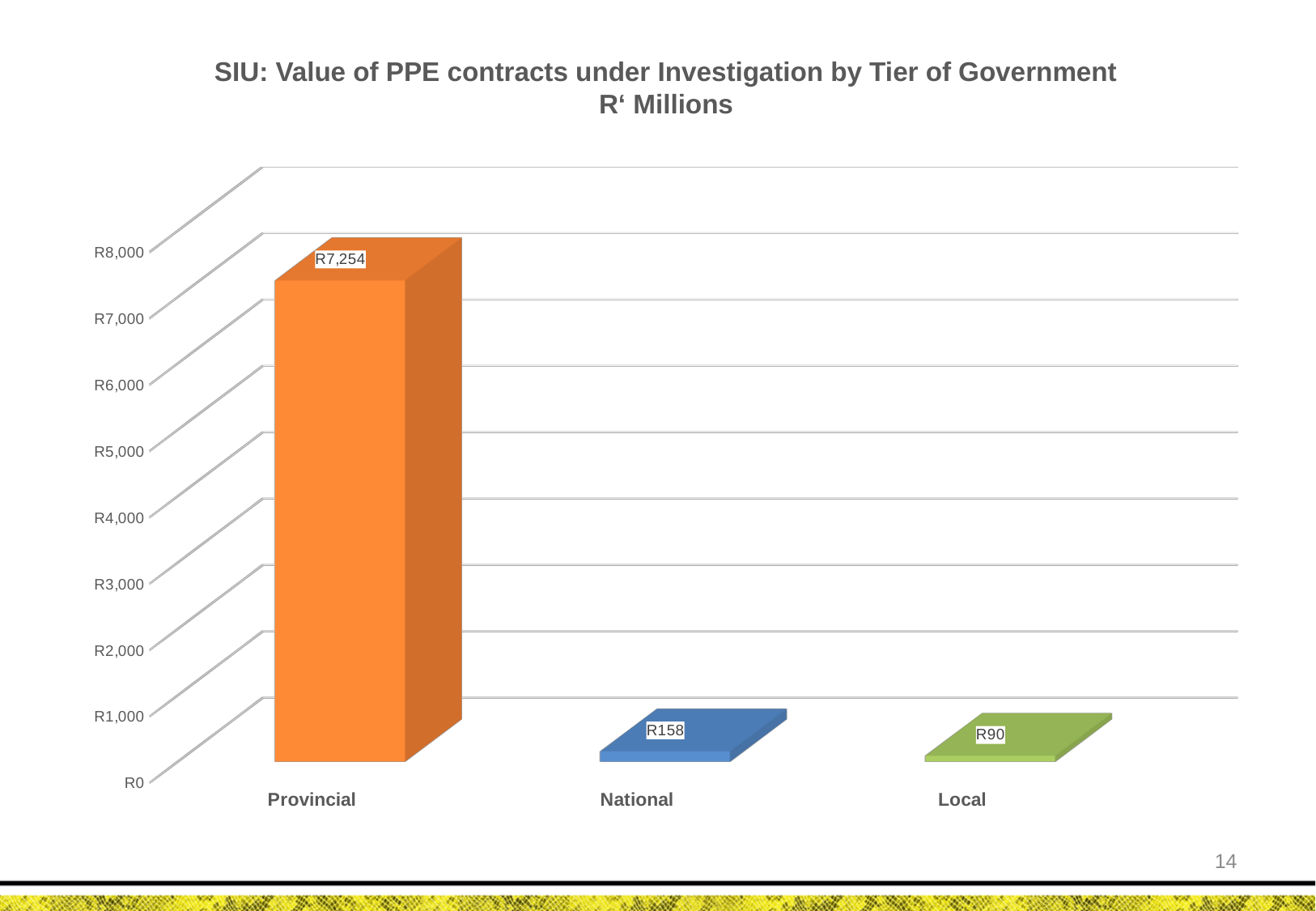
What is the value of PPE contracts under investigation for the Provincial tier? R7,254 Which tier of government has the highest value of PPE contracts under investigation? Provincial What kind of chart is shown on the slide? Bar chart Which tier of government has the lowest value of PPE contracts under investigation? Local Is the value for Provincial greater or less than R7,000? greater In what units are the values on the chart expressed, according to the title? R' Millions What is the value of PPE contracts under investigation for the National tier? R158 What is the difference between the National and Local values? R68 What is the value of PPE contracts under investigation for the Local tier? R90 What is the difference between the Provincial and National values? R7,096 How many tiers of government are shown on the chart? 3 Which is larger, the value for National or the value for Local? National